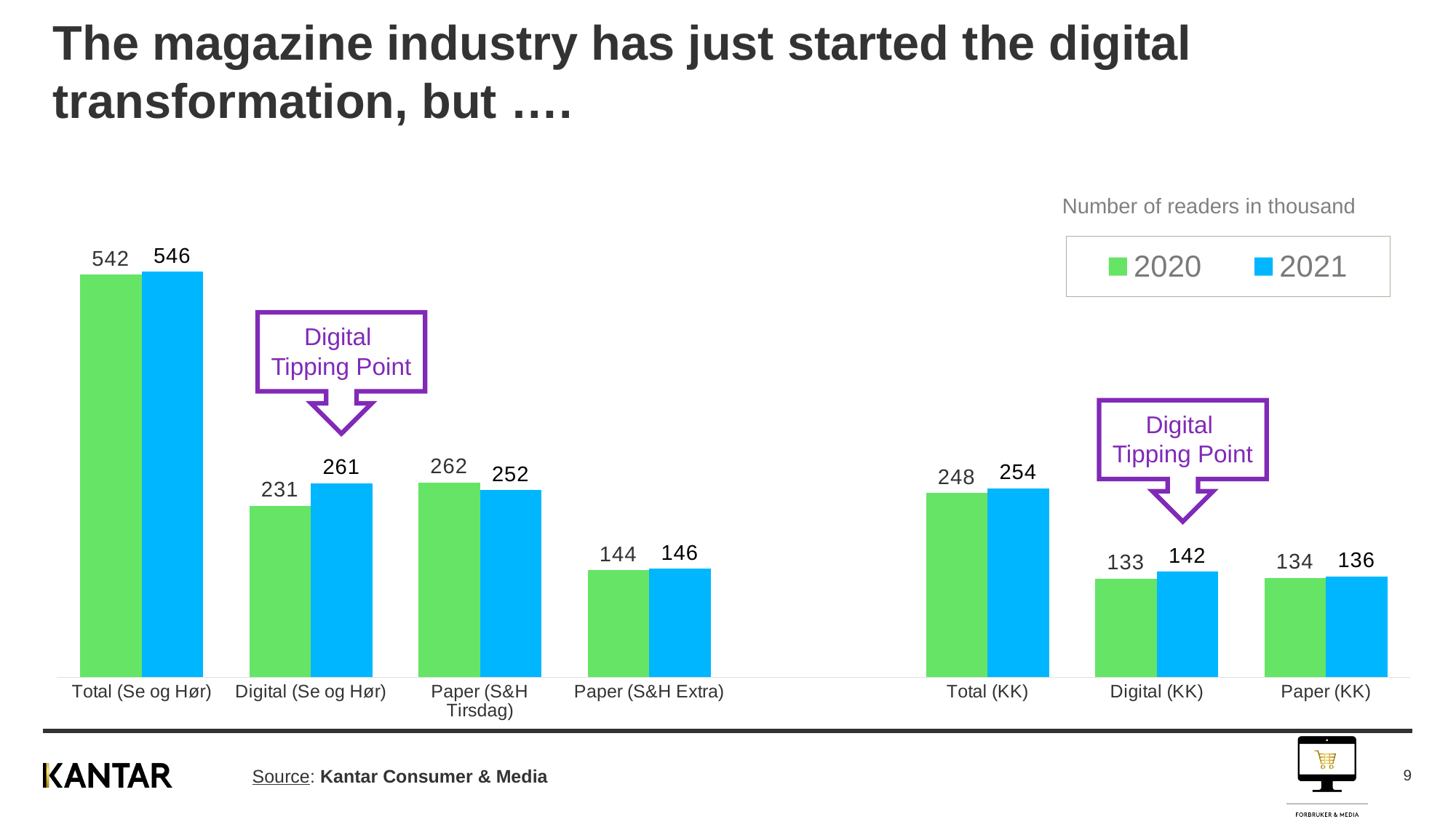
What kind of chart is shown on the slide? Bar chart Which category has the highest 2021 value? Total (Se og Hør) How many categories are shown on the x axis? 7 What is the 2021 value for Digital (Se og Hør)? 261 What is the 2020 value for Digital (KK)? 133 What is the 2021 value for Total (KK)? 254 How many series does the legend list? 2 What is the difference between the 2020 and 2021 values for Paper (S&H Tirsdag)? 10 Which category has the lowest 2020 value? Digital (KK) What is the 2020 value for Paper (S&H Tirsdag)? 262 What is the difference between the 2021 and 2020 values for Digital (Se og Hør)? 30 For Digital (KK), is the 2020 value or the 2021 value larger? 2021